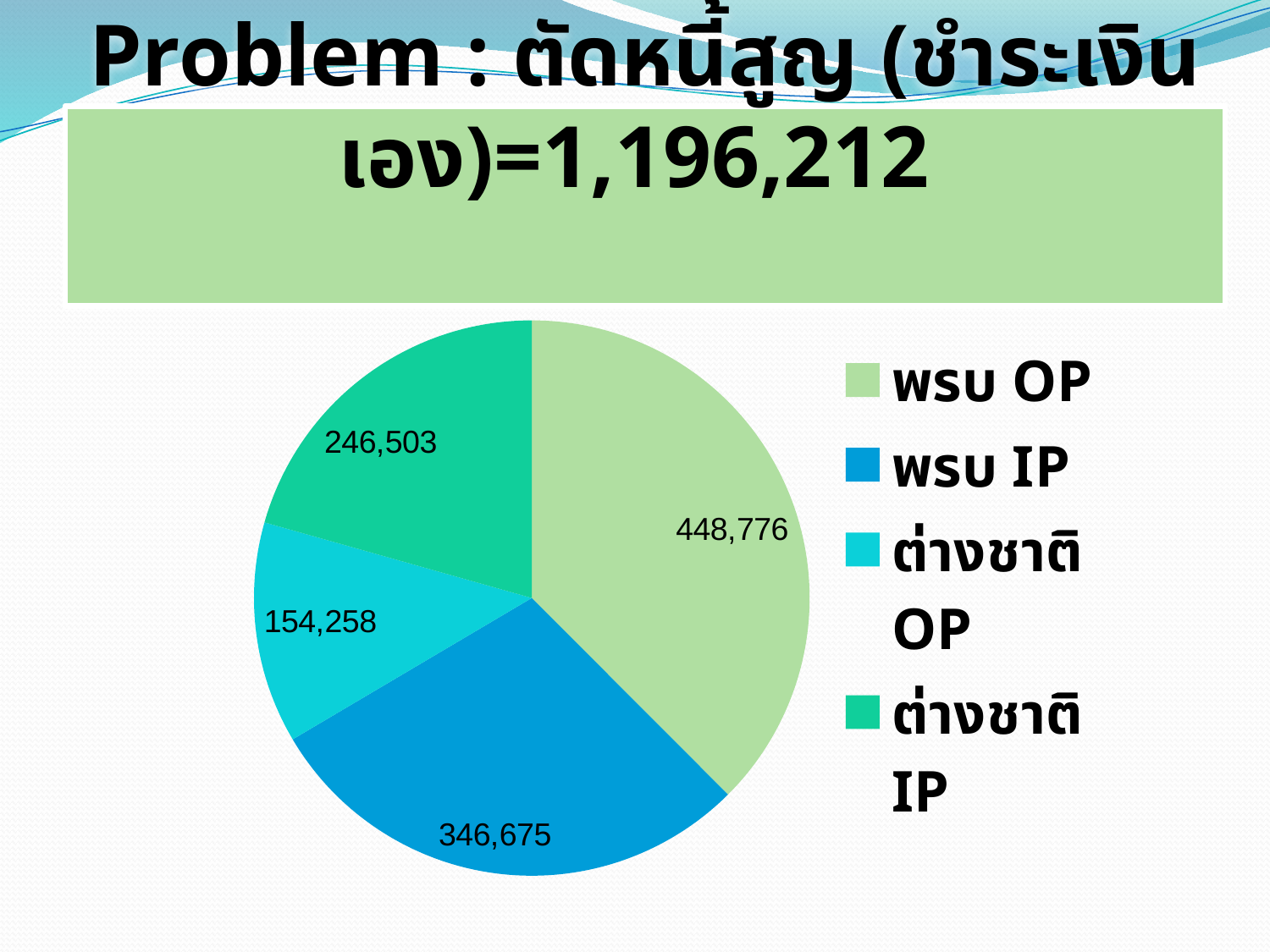
Which category has the smallest slice of the pie? ต่างชาติ OP What is the value for ต่างชาติ OP? 154,258 Which category has the largest slice of the pie? พรบ OP What is the value for ต่างชาติ IP? 246,503 What is the difference between the values for ต่างชาติ IP and ต่างชาติ OP? 92,245 How many categories does the pie chart have? 4 What is the value for พรบ OP? 448,776 Which is larger, the value for พรบ IP or the value for ต่างชาติ IP? พรบ IP What is the difference between the values for พรบ OP and พรบ IP? 102,101 What share of the pie does พรบ OP represent, to one decimal place? 37.5% What type of chart is shown on the slide? pie chart What is the value for พรบ IP? 346,675